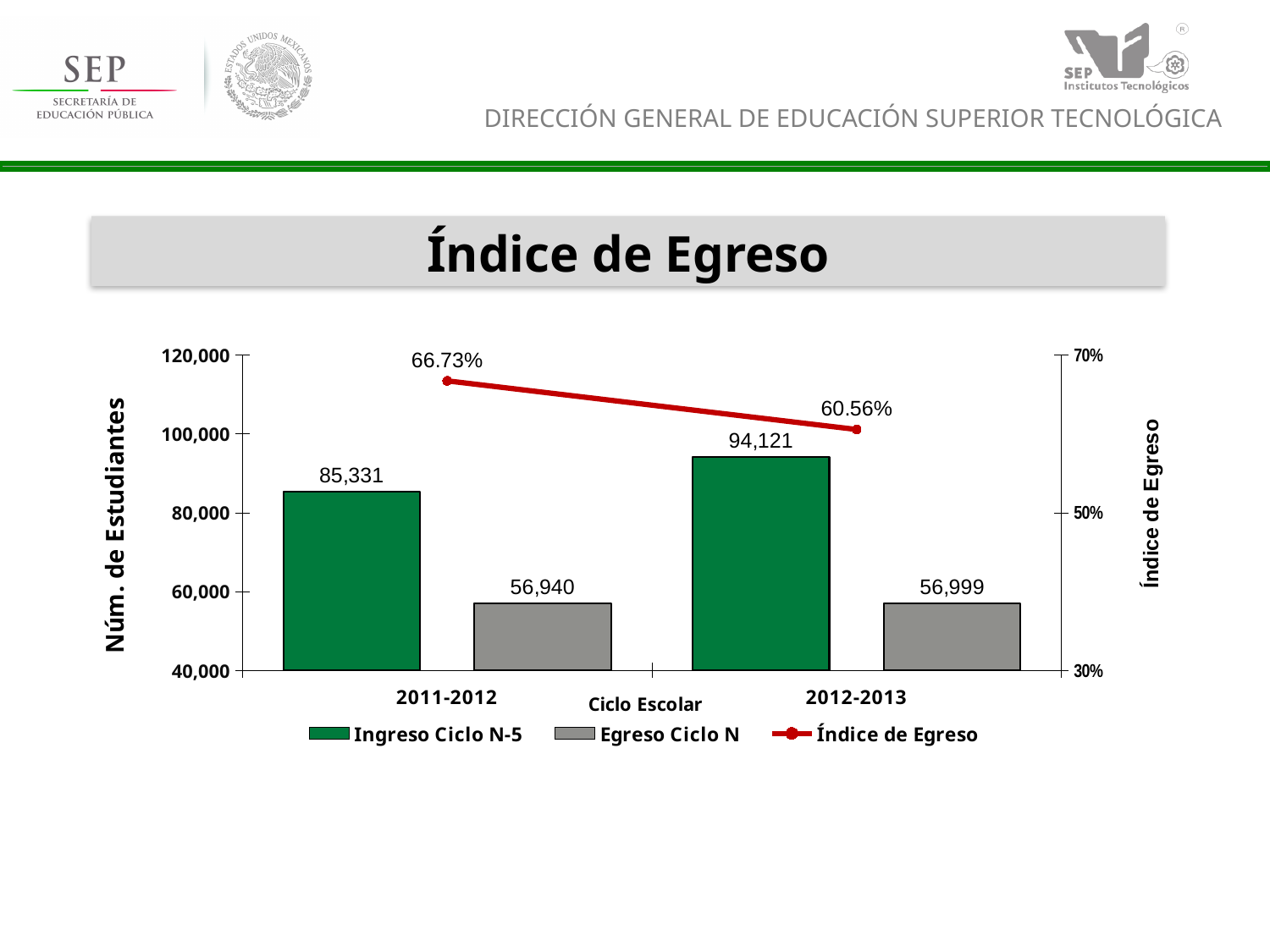
What is the Índice de Egreso for 2011-2012? 66.73% What is the difference between Ingreso Ciclo N-5 and Egreso Ciclo N in 2011-2012? 28,391 How many school cycles are shown on the x axis? 2 Which school cycle has the higher Ingreso Ciclo N-5 value? 2012-2013 What is the Índice de Egreso for 2012-2013? 60.56% Does the Índice de Egreso rise or fall from 2011-2012 to 2012-2013? fall What is the value of Ingreso Ciclo N-5 for 2011-2012? 85,331 What is the title of the chart? Índice de Egreso How many series does the legend list? 3 Which is larger: Ingreso Ciclo N-5 in 2011-2012 or Egreso Ciclo N in 2012-2013? Ingreso Ciclo N-5 in 2011-2012 What is the value of Egreso Ciclo N for 2012-2013? 56,999 What is the difference between Ingreso Ciclo N-5 in 2012-2013 and in 2011-2012? 8,790